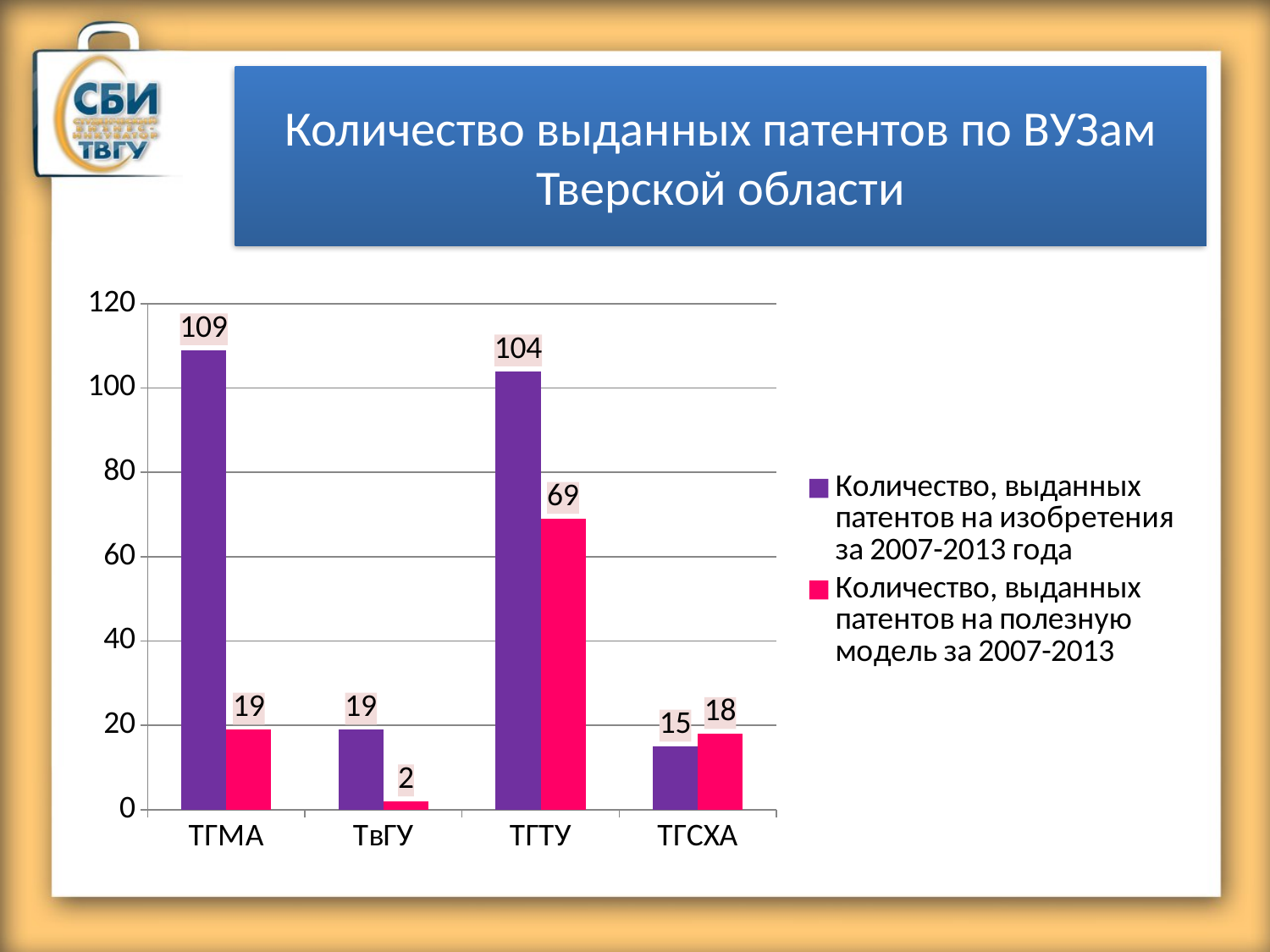
Is the number of patents for utility models for ТГТУ greater or less than 60? greater How many series does the legend list? 2 What is the number of patents for inventions for ТГСХА? 15 Which university has the highest number of patents for inventions? ТГМА What is the number of patents for utility models for ТвГУ? 2 Which university has the lowest number of patents for utility models? ТвГУ Which is larger for ТГСХА: patents for inventions or patents for utility models? Patents for utility models (18) What is the number of patents for utility models (Количество, выданных патентов на полезную модель за 2007-2013) for ТГТУ? 69 What type of chart is shown on the slide? Bar chart What is the number of patents for inventions (Количество, выданных патентов на изобретения за 2007-2013 года) for ТГМА? 109 How many universities are shown on the x axis? 4 What is the difference between the number of patents for inventions for ТГМА and ТГТУ? 5